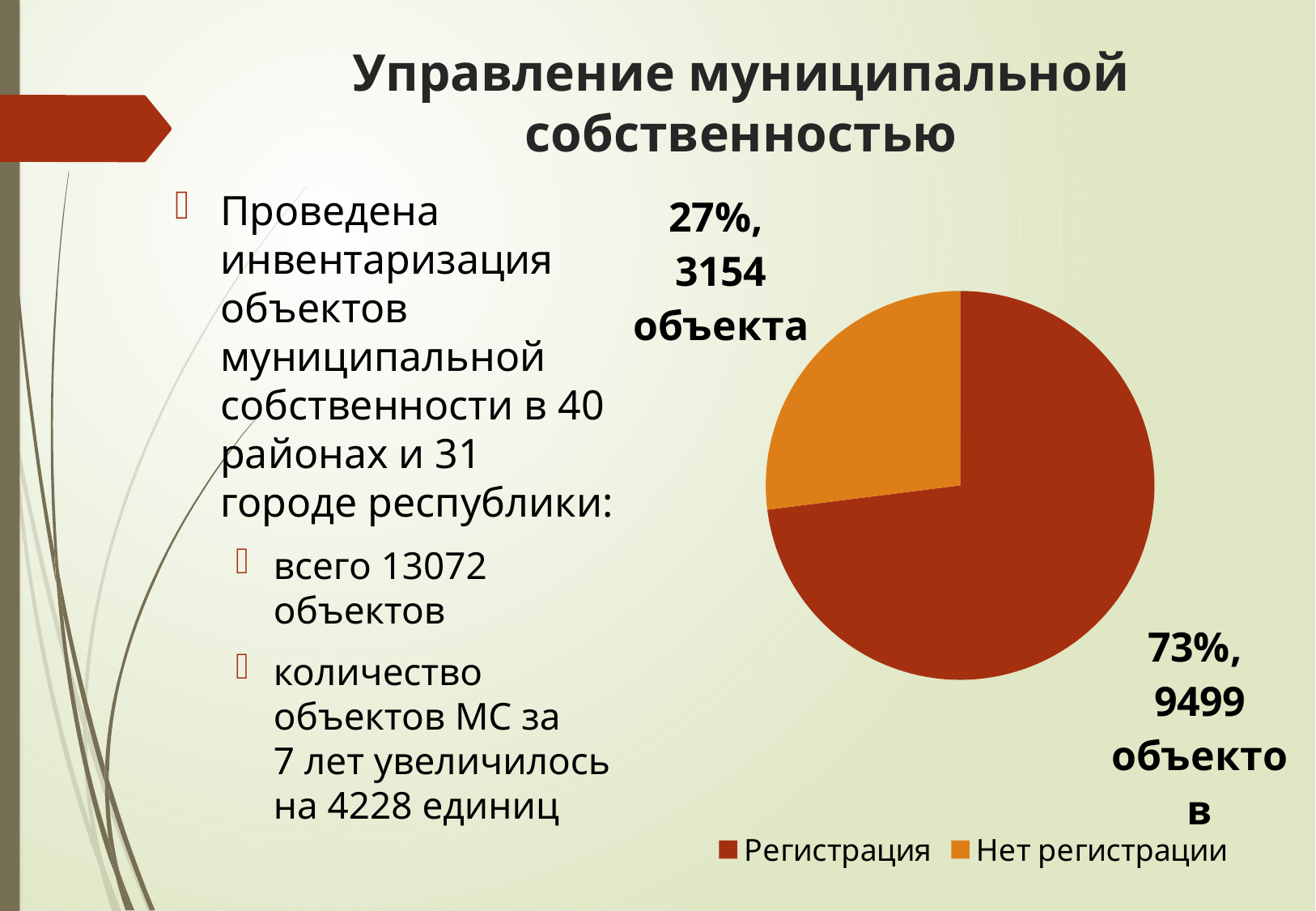
Which slice of the pie chart is the largest? Регистрация What share of the pie does the "Регистрация" slice represent? 73% What colour is the "Нет регистрации" slice in the pie chart? orange How many entries does the legend of the pie chart list? 2 How many objects does the "Нет регистрации" slice correspond to? 3154 What kind of chart is shown on the slide? pie chart How many slices does the pie chart have? 2 Which slice of the pie chart is the smallest? Нет регистрации Which is larger: the number of objects for "Регистрация" or for "Нет регистрации"? Регистрация How many objects does the "Регистрация" slice correspond to? 9499 What share of the pie does the "Нет регистрации" slice represent? 27% What is the difference in the number of objects between "Регистрация" and "Нет регистрации"? 6345